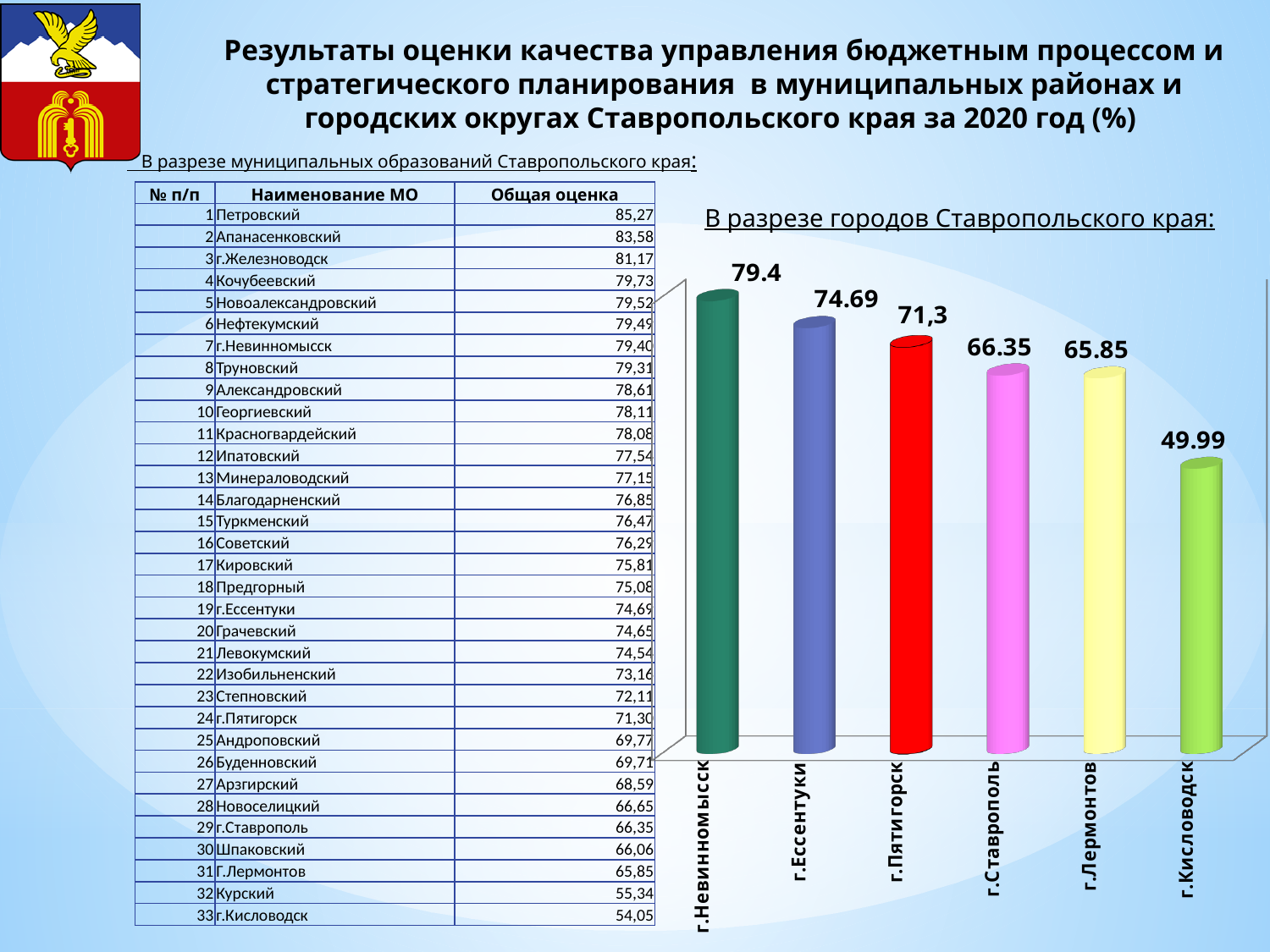
What is the value for г.Невинномысск in the chart? 79.4 What is the value for г.Ессентуки in the chart? 74.69 Do the values in the chart rise or fall from left to right? Fall What is the value for г.Кисловодск in the chart? 49.99 Which city has the highest value in the chart? г.Невинномысск Which has a larger value in the chart, г.Ставрополь or г.Лермонтов? г.Ставрополь What is the value for г.Пятигорск in the chart? 71,3 What is the difference between the values for г.Невинномысск and г.Ессентуки in the chart? 4.71 How many cities are shown in the chart? 6 Which city has the lowest value in the chart? г.Кисловодск What is the difference between the values for г.Невинномысск and г.Кисловодск in the chart? 29.41 What kind of chart is shown on the slide? Bar chart